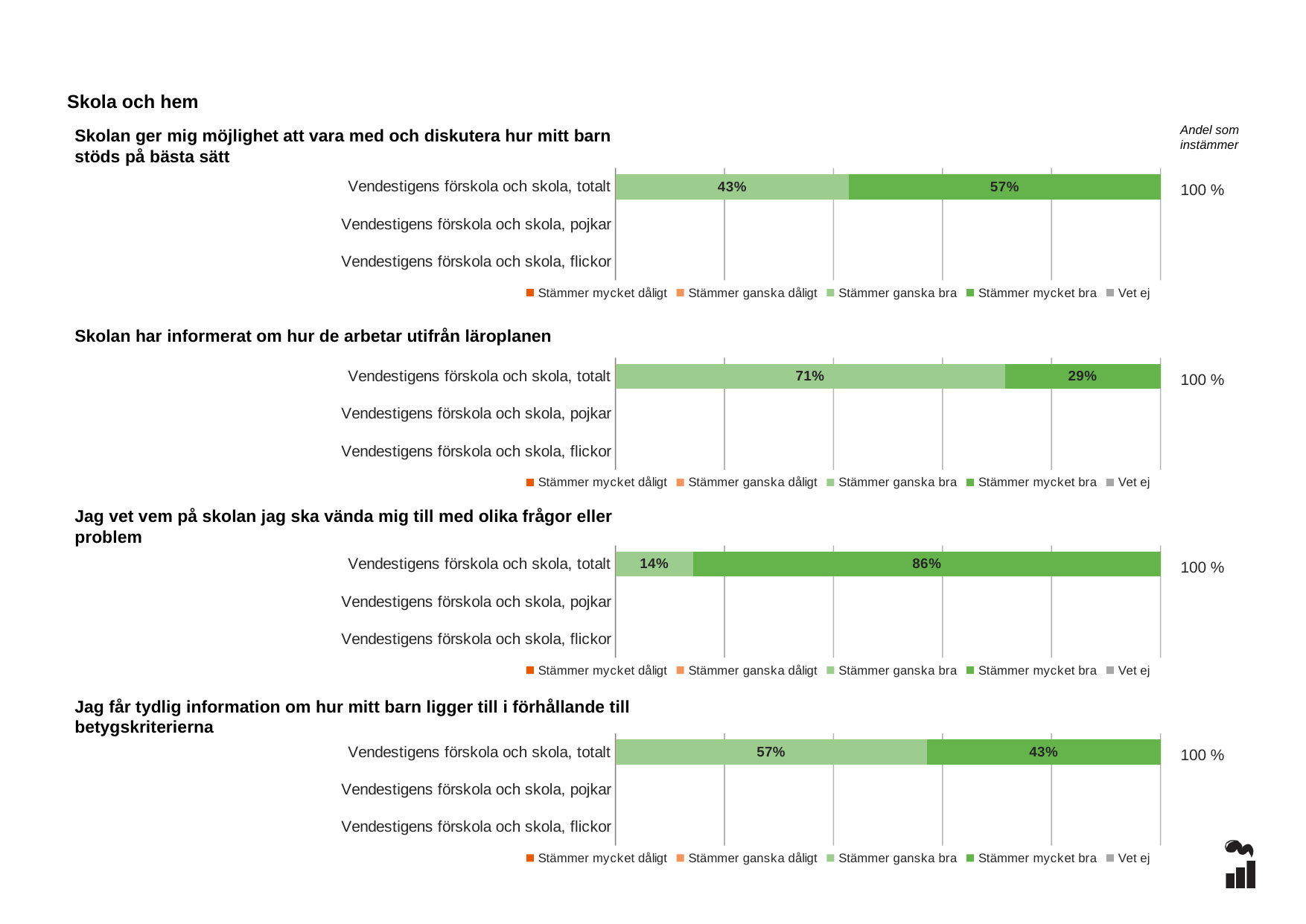
In the chart 'Skolan ger mig möjlighet att vara med och diskutera hur mitt barn stöds på bästa sätt', what is the 'Stämmer mycket bra' value for Vendestigens förskola och skola, totalt? 57% In the chart 'Skolan har informerat om hur de arbetar utifrån läroplanen', which is larger for the totalt row: 'Stämmer ganska bra' or 'Stämmer mycket bra'? Stämmer ganska bra In the chart 'Jag vet vem på skolan jag ska vända mig till med olika frågor eller problem', what is the difference between the 'Stämmer mycket bra' and 'Stämmer ganska bra' values for the totalt row? 72% In the chart 'Skolan ger mig möjlighet att vara med och diskutera hur mitt barn stöds på bästa sätt', what is the 'Stämmer ganska bra' value for Vendestigens förskola och skola, totalt? 43% In the chart 'Jag får tydlig information om hur mitt barn ligger till i förhållande till betygskriterierna', what is the total of the stacked bar for Vendestigens förskola och skola, totalt? 100% How many series does the legend list in the chart 'Skolan ger mig möjlighet att vara med och diskutera hur mitt barn stöds på bästa sätt'? 5 In the chart 'Jag får tydlig information om hur mitt barn ligger till i förhållande till betygskriterierna', what is the 'Stämmer ganska bra' value for Vendestigens förskola och skola, totalt? 57% In the chart 'Jag vet vem på skolan jag ska vända mig till med olika frågor eller problem', what is the 'Stämmer mycket bra' value for Vendestigens förskola och skola, totalt? 86% How many categories are shown on the y axis of the chart 'Jag vet vem på skolan jag ska vända mig till med olika frågor eller problem'? 3 In the chart 'Skolan har informerat om hur de arbetar utifrån läroplanen', what is the 'Stämmer ganska bra' value for Vendestigens förskola och skola, totalt? 71% What kind of chart is 'Skolan har informerat om hur de arbetar utifrån läroplanen'? Stacked bar chart In the chart 'Skolan har informerat om hur de arbetar utifrån läroplanen', what is the 'Stämmer mycket bra' value for Vendestigens förskola och skola, totalt? 29%